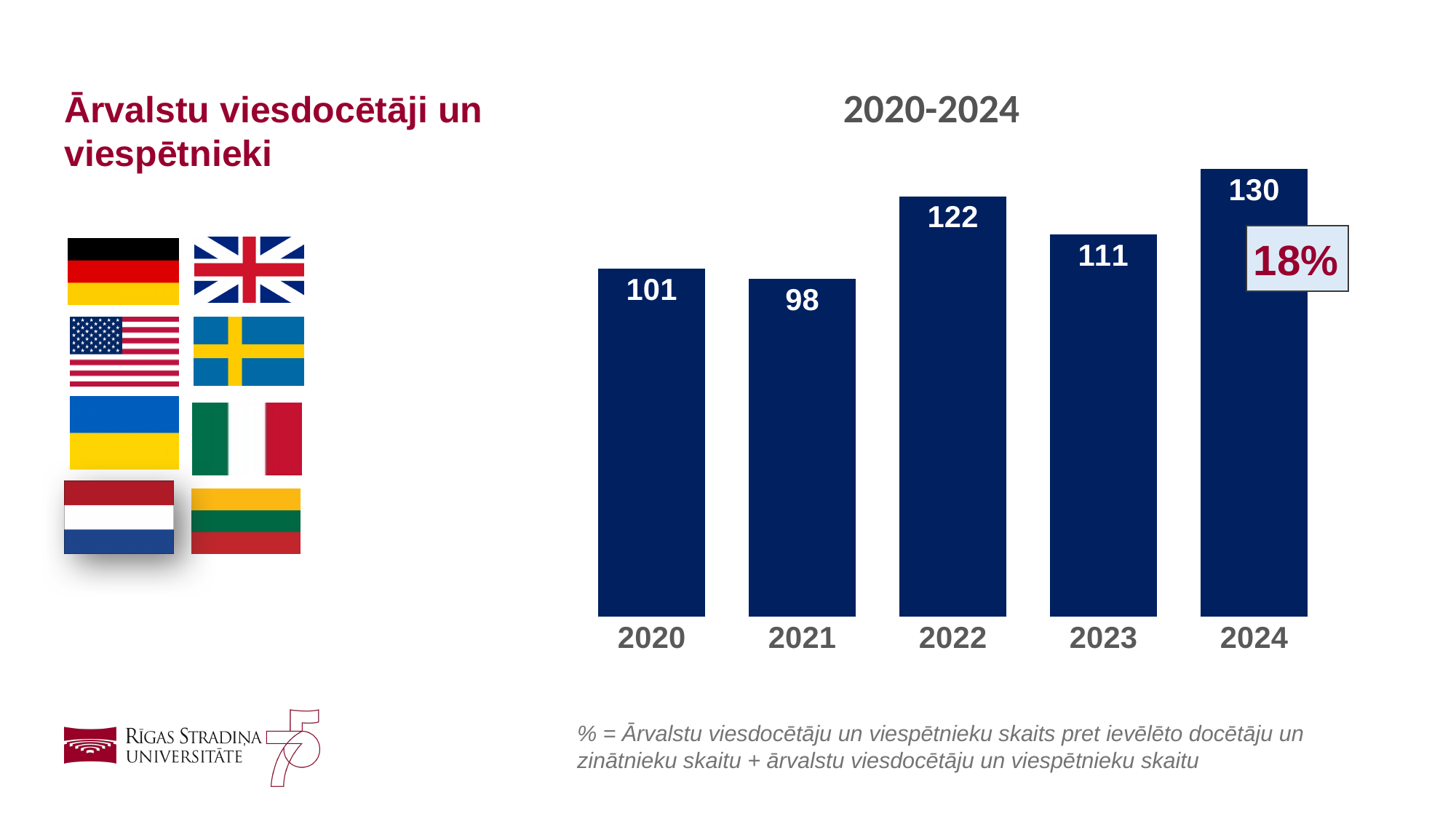
Which year has the highest value? 2024 Which year has the lowest value? 2021 What is the value for 2021? 98 How many years are shown on the chart? 5 What is the value for 2024? 130 What kind of chart is shown on the slide? Bar chart What is the value for 2022? 122 Which is larger, the value for 2022 or the value for 2023? 2022 What is the value for 2020? 101 What is the value for 2023? 111 What is the difference between the values for 2024 and 2020? 29 What percentage is shown in the box next to the 2024 bar? 18%